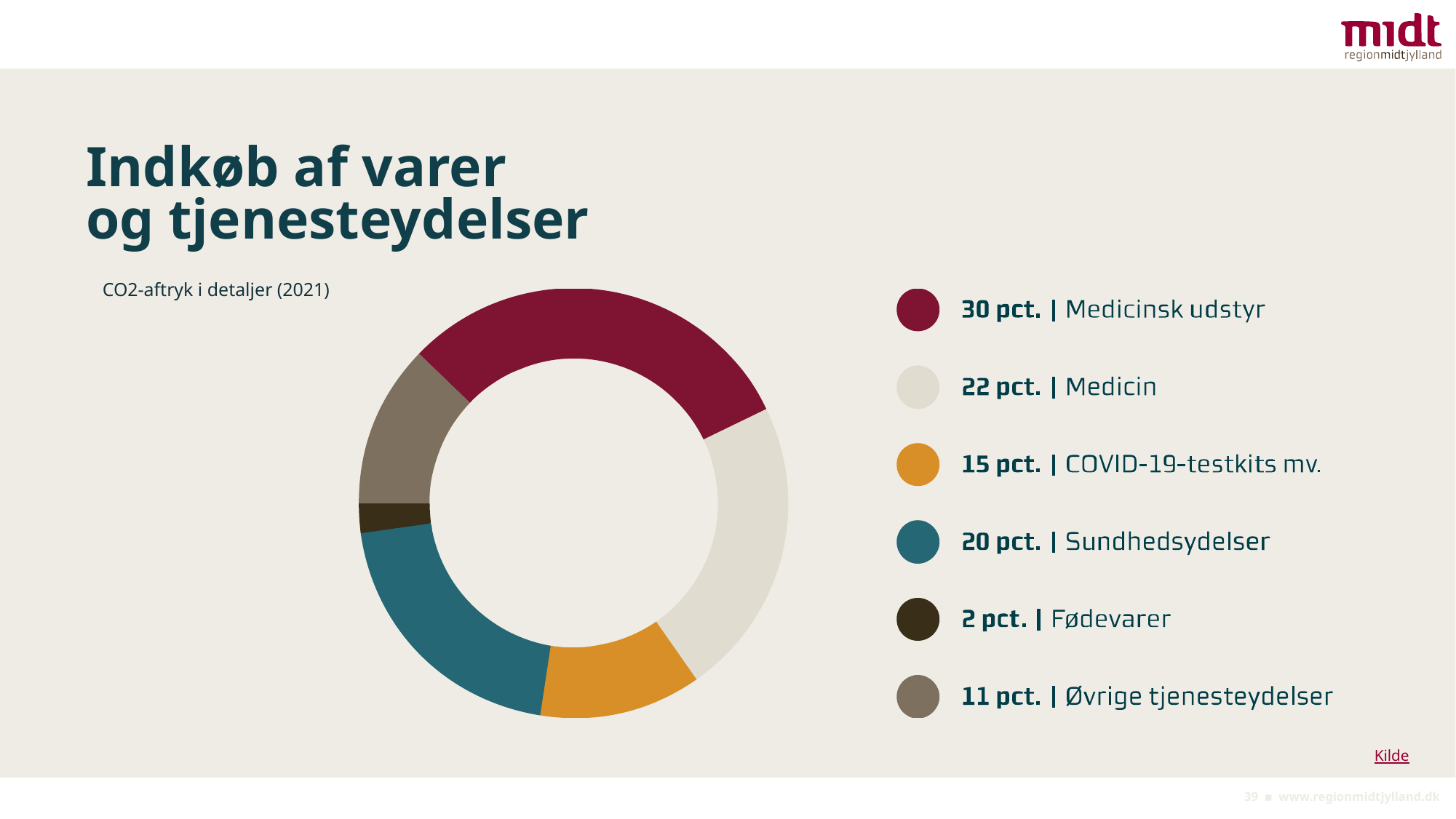
What is the subtitle shown above the chart? CO2-aftryk i detaljer (2021) Which category has the largest share of the donut chart? Medicinsk udstyr Which category has the smallest share of the donut chart? Fødevarer What type of chart is shown on the slide? Donut (pie) chart Which is larger, the share for Sundhedsydelser or the share for COVID-19-testkits mv.? Sundhedsydelser What percentage is shown for Medicin? 22 pct. How many categories are shown in the donut chart? 6 What is the combined share of Fødevarer and Øvrige tjenesteydelser? 13 pct. What is the difference in percentage points between Medicinsk udstyr and Medicin? 8 pct. What percentage is shown for COVID-19-testkits mv.? 15 pct. What share of the CO2 footprint does Medicinsk udstyr account for? 30 pct. What percentage is shown for Sundhedsydelser? 20 pct.